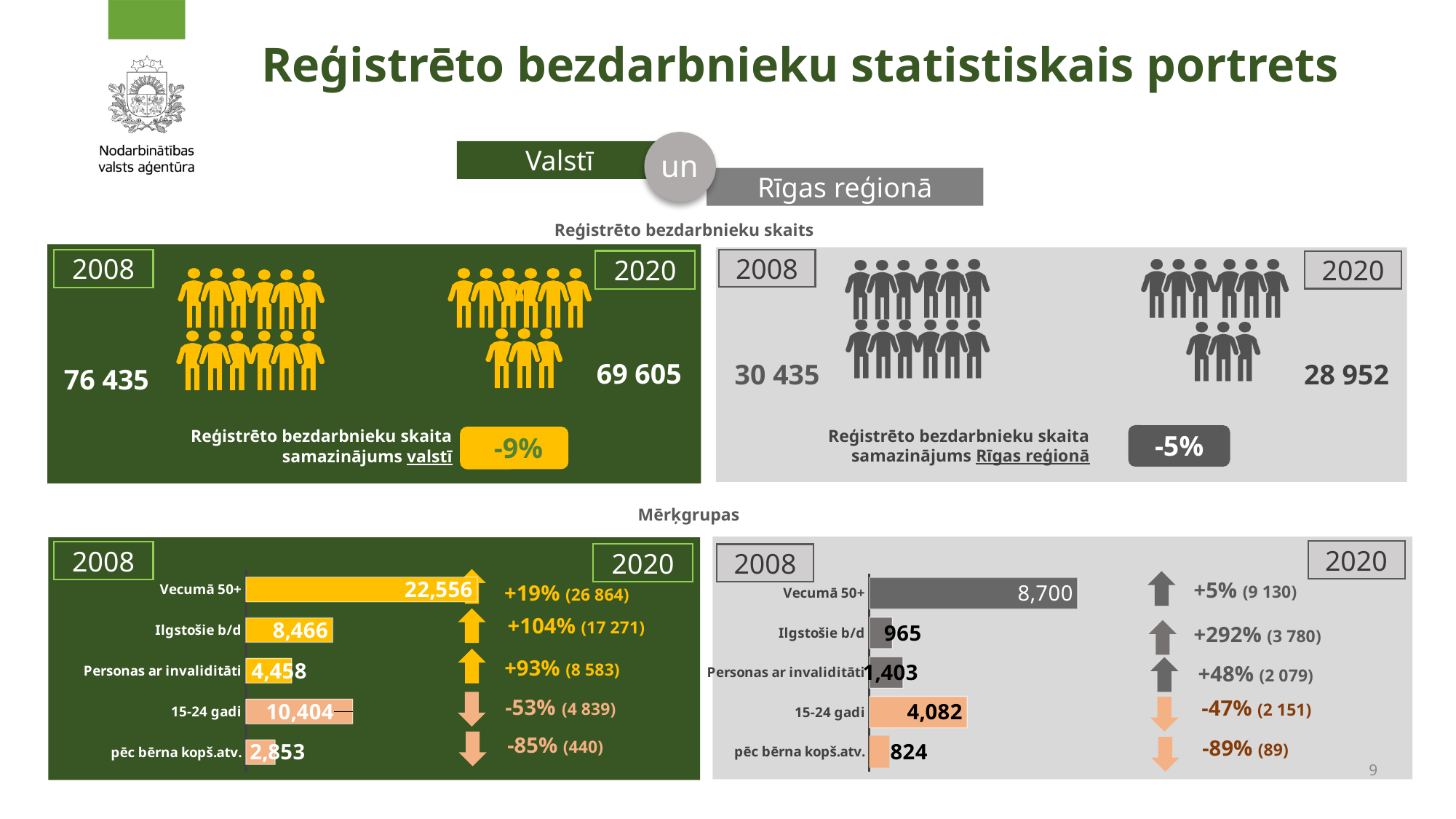
In the bottom-right bar chart (Mērķgrupas, Rīgas reģionā), what is the 2008 value for Ilgstošie b/d? 965 In the bottom-right bar chart (Mērķgrupas, Rīgas reģionā), which is larger in 2008: Personas ar invaliditāti or Ilgstošie b/d? Personas ar invaliditāti In the bottom-right bar chart (Mērķgrupas, Rīgas reģionā), what is the 2008 value for pēc bērna kopš.atv.? 824 In the bottom-left bar chart (Mērķgrupas, Valstī), what is the 2008 value for Vecumā 50+? 22,556 In the bottom-right bar chart (Mērķgrupas, Rīgas reģionā), which category has the highest 2008 value? Vecumā 50+ How many categories does the bottom-left bar chart (Mērķgrupas, Valstī) show? 5 In the bottom-left bar chart (Mērķgrupas, Valstī), which category has the lowest 2008 value? pēc bērna kopš.atv. What kind of chart is the bottom-right chart (Mērķgrupas, Rīgas reģionā)? Bar chart In the bottom-left bar chart (Mērķgrupas, Valstī), what is the difference between the 2008 values for Vecumā 50+ and Ilgstošie b/d? 14,090 In the bottom-left bar chart (Mērķgrupas, Valstī), what is the 2008 value for 15-24 gadi? 10,404 In the bottom-left bar chart (Mērķgrupas, Valstī), which category has the highest 2008 value? Vecumā 50+ In the bottom-right bar chart (Mērķgrupas, Rīgas reģionā), which category has the lowest 2008 value? pēc bērna kopš.atv.